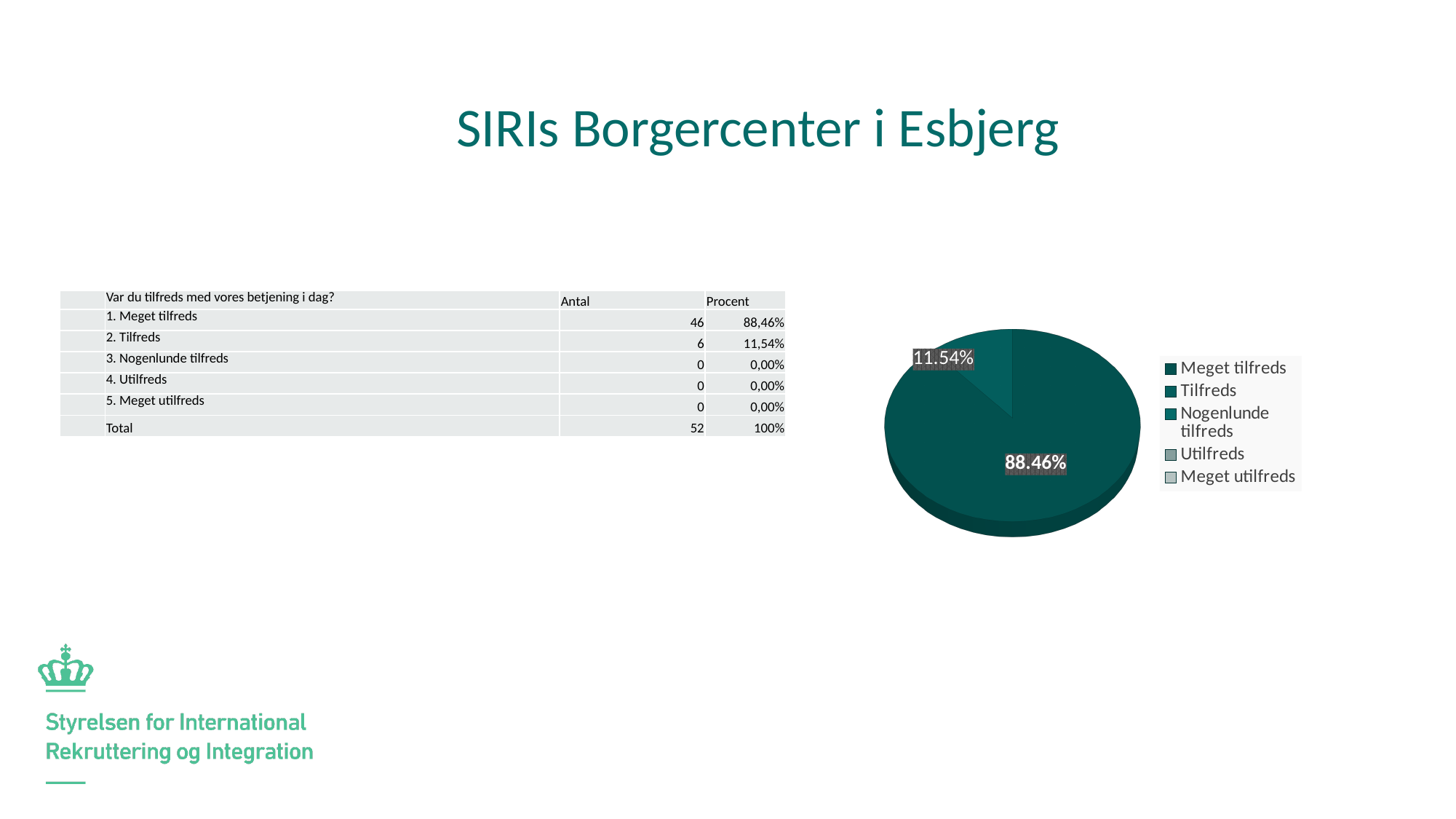
What is the last entry listed in the pie chart's legend? Meget utilfreds Is the share of the Meget tilfreds slice greater or less than 50%? greater What is the title of the slide containing the pie chart? SIRIs Borgercenter i Esbjerg What kind of chart is shown on the slide? pie chart What is the difference in percentage points between the Meget tilfreds slice and the Tilfreds slice in the pie chart? 76.92 What share of the pie chart does the Meget tilfreds slice represent? 88.46% Which is larger in the pie chart, the Meget tilfreds slice or the Tilfreds slice? Meget tilfreds How many entries does the legend of the pie chart list? 5 What share of the pie chart does the Tilfreds slice represent? 11.54% How many slices are visibly drawn in the pie chart? 2 Is the share of the Tilfreds slice greater or less than 25%? less Which category has the largest slice in the pie chart? Meget tilfreds